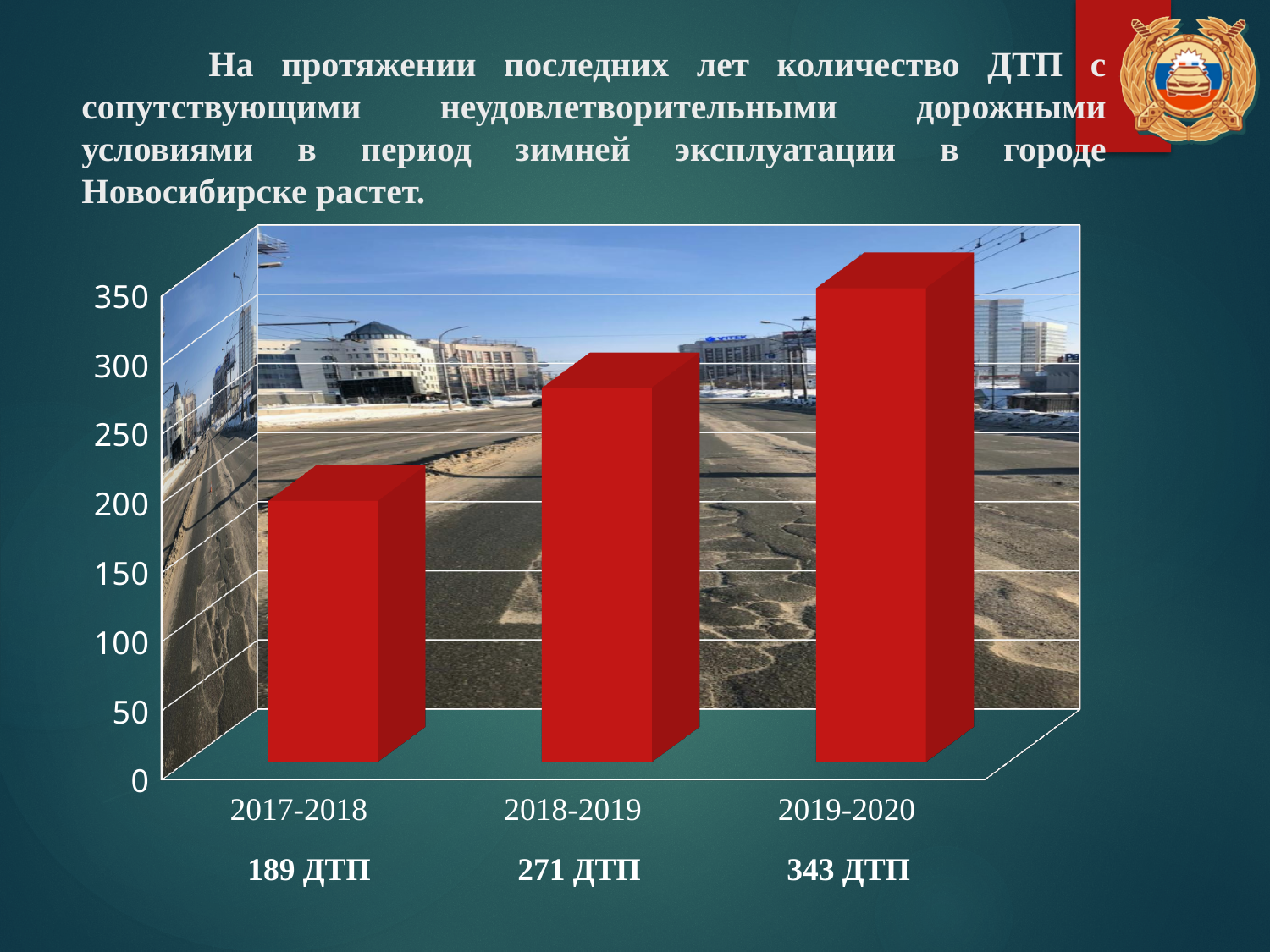
What kind of chart is shown on the slide? bar chart What is the value for 2017-2018? 189 ДТП How many periods are shown on the x axis? 3 Which is larger, the value for 2018-2019 or the value for 2019-2020? 2019-2020 What is the difference between the values for 2019-2020 and 2017-2018? 154 What is the value for 2018-2019? 271 ДТП What is the difference between the values for 2018-2019 and 2017-2018? 82 Do the values rise or fall from 2017-2018 to 2019-2020? rise Which period has the highest number of ДТП? 2019-2020 Which period has the lowest number of ДТП? 2017-2018 What is the value for 2019-2020? 343 ДТП Is the value for 2018-2019 greater or less than 250? greater